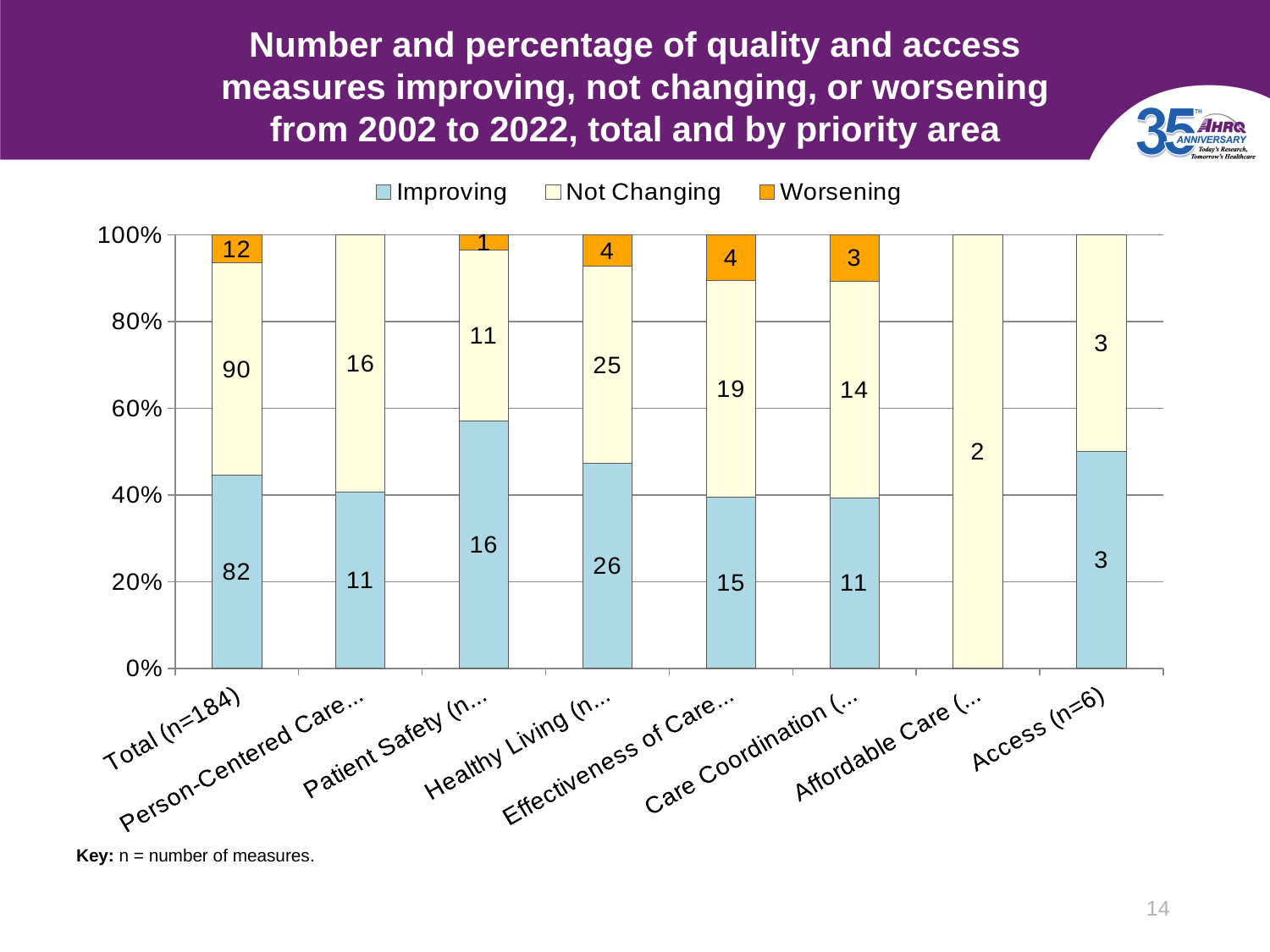
What is the Not Changing value for Healthy Living? 25 How many series does the legend list? 3 What is the Not Changing value for Affordable Care? 2 What is the Worsening value for Care Coordination? 3 How many categories are shown on the x axis? 8 What is the sum of the Improving, Not Changing and Worsening values for Total (n=184)? 184 Which category has the highest Improving value? Total (n=184) Which is larger for Effectiveness of Care: the Improving value or the Not Changing value? Not Changing What kind of chart is this? Stacked bar chart Among the categories with a Worsening label, which has the lowest Worsening value? Patient Safety What is the Improving value for Total (n=184)? 82 What is the difference between the Not Changing and Improving values for Total (n=184)? 8